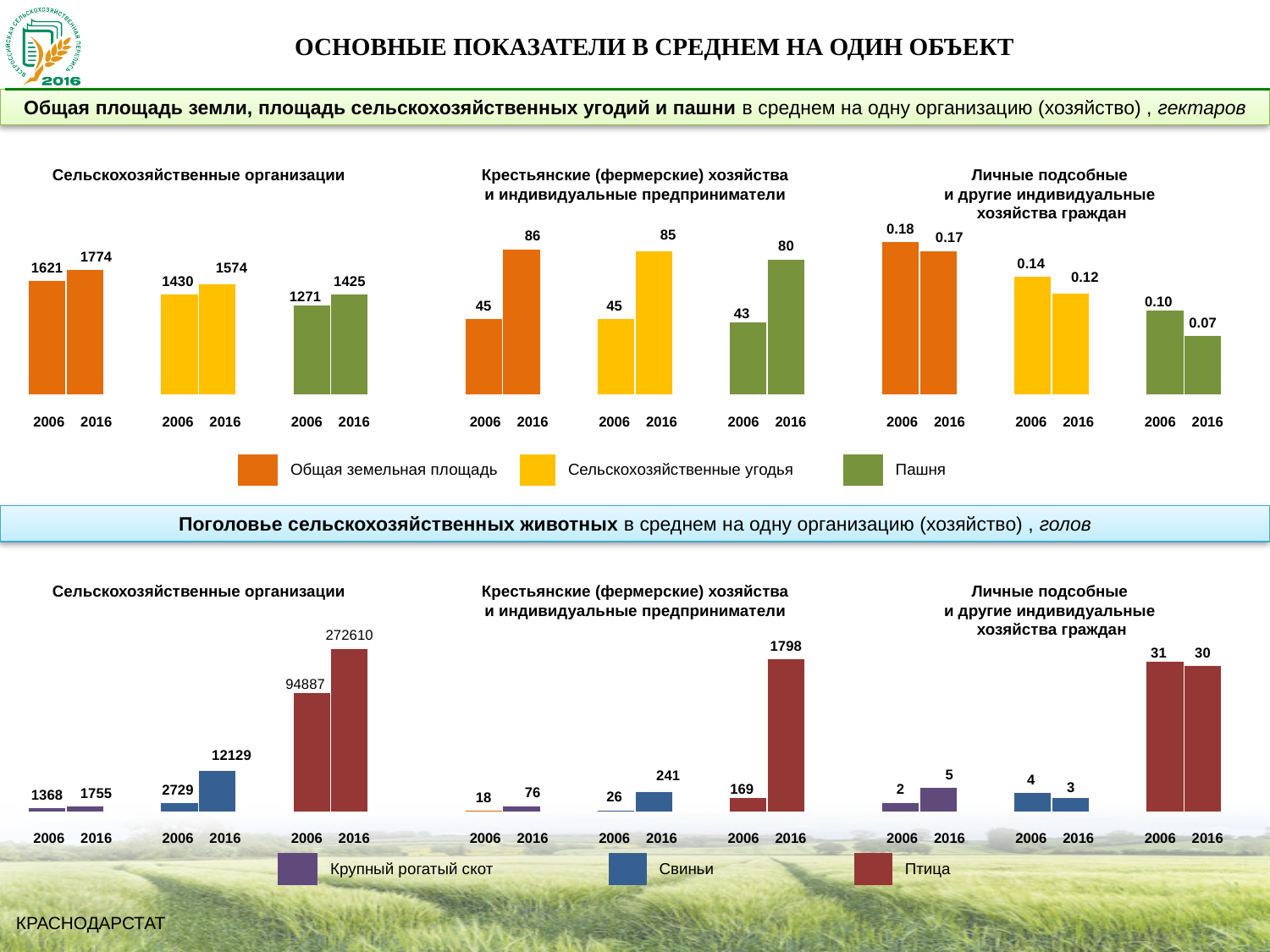
In the land-area chart for 'Крестьянские (фермерские) хозяйства и индивидуальные предприниматели' (top middle), what is the value of 'Пашня' in 2006? 43 How many series does the legend of the livestock charts (bottom row) list? 3 In the livestock chart for 'Личные подсобные и другие индивидуальные хозяйства граждан' (bottom right), what is the value of 'Крупный рогатый скот' in 2016? 5 In the land-area chart for 'Сельскохозяйственные организации' (top left), what is the value of 'Общая земельная площадь' in 2016? 1774 In the land-area chart for 'Сельскохозяйственные организации' (top left), by how much did 'Пашня' change from 2006 to 2016? 154 In the land-area chart for 'Личные подсобные и другие индивидуальные хозяйства граждан' (top right), did the values rise or fall from 2006 to 2016? fall What type of chart is used for the land-area charts in the top row? bar chart In the livestock chart for 'Крестьянские (фермерские) хозяйства и индивидуальные предприниматели' (bottom middle), which is larger: 'Свиньи' in 2016 or 'Птица' in 2006? Свиньи in 2016 (241) In the livestock chart for 'Сельскохозяйственные организации' (bottom left), what is the difference between 'Свиньи' in 2016 and 2006? 9400 In the land-area chart for 'Крестьянские (фермерские) хозяйства и индивидуальные предприниматели' (top middle), which bar is the highest? Общая земельная площадь, 2016 (86) In the land-area chart for 'Личные подсобные и другие индивидуальные хозяйства граждан' (top right), what is the value of 'Сельскохозяйственные угодья' in 2016? 0.12 In the livestock chart for 'Сельскохозяйственные организации' (bottom left), what is the value of 'Птица' in 2016? 272610